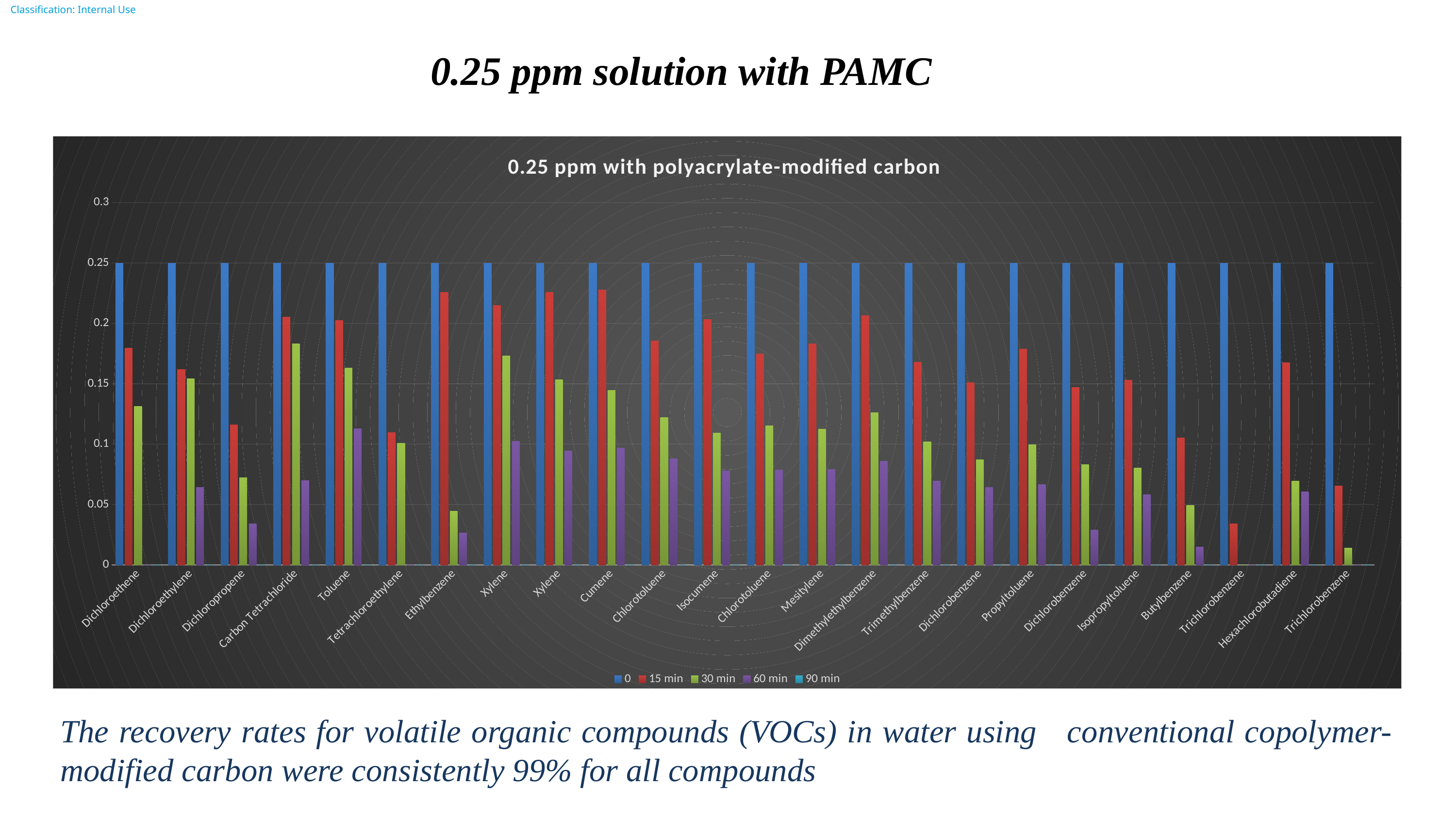
What is the title of the chart? 0.25 ppm with polyacrylate-modified carbon How many compound categories are shown on the x axis? 24 What is the value of the "0" series for Toluene? 0.25 Is the 15 min value for Ethylbenzene greater or less than 0.2? greater Which is larger, the 60 min value for Toluene or the 60 min value for Dichloroethylene? Toluene How many series does the legend list? 5 Is the 60 min value for Dichloropropene greater or less than 0.05? less Does the "0" series rise, fall or stay flat across the categories along the x axis? stays flat Which is larger, the 15 min value for Carbon Tetrachloride or the 15 min value for Dichloropropene? Carbon Tetrachloride Is the 15 min value for Dichloropropene greater or less than 0.1? greater What kind of chart is shown on the slide? bar chart